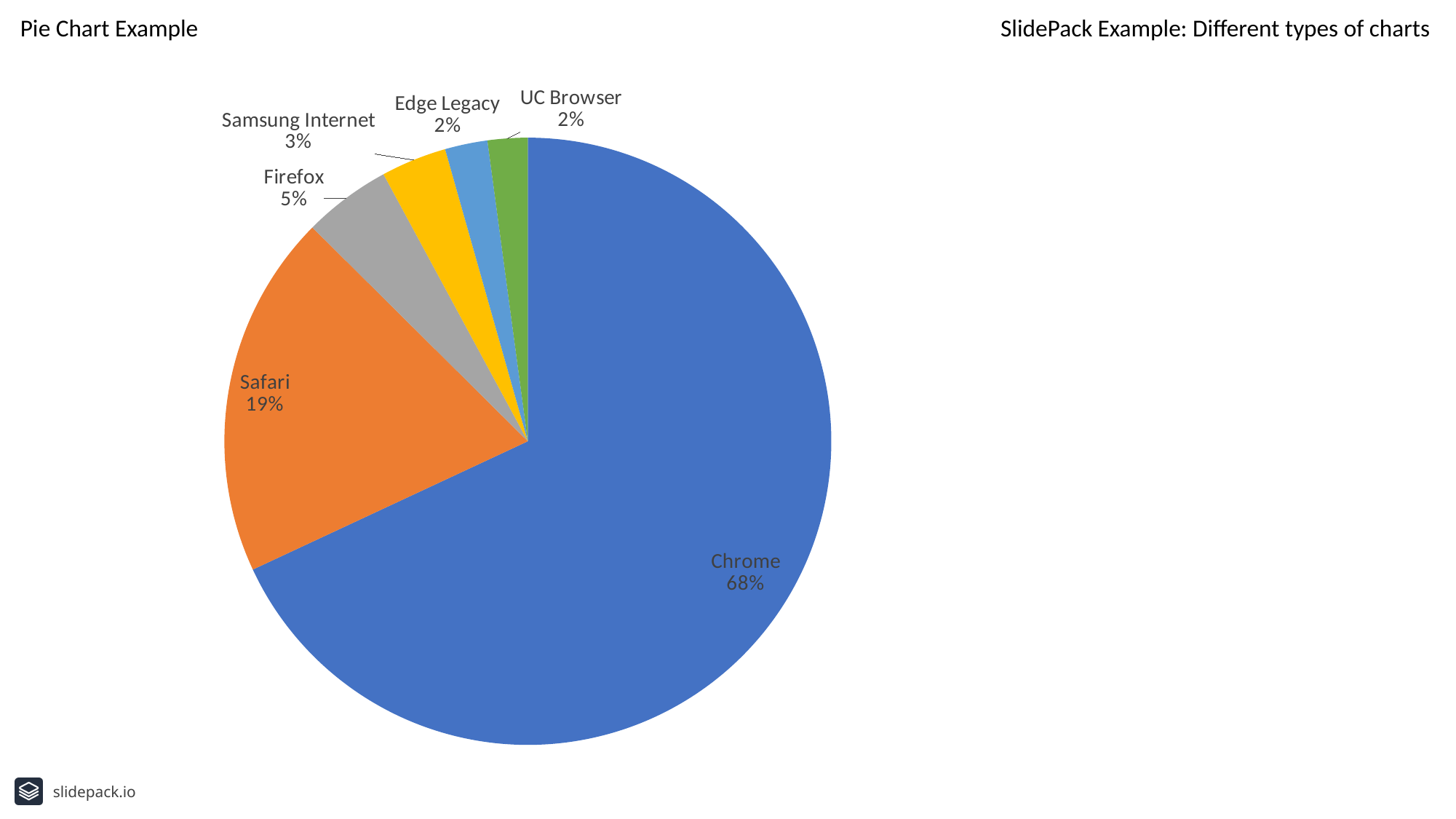
What is the combined share of Edge Legacy and UC Browser? 4% What share of the pie does Safari have? 19% What is the value shown for Samsung Internet? 3% What is the difference between the Safari and Firefox shares? 14% What colour is the Safari slice? Orange How many slices does the pie chart have? 6 What share of the pie does Chrome have? 68% Which browser has the largest slice of the pie? Chrome What is the difference between the Chrome and Safari shares? 49% What is the value shown for Firefox? 5% Which is larger, the Firefox slice or the Samsung Internet slice? Firefox What kind of chart is shown on the slide? Pie chart